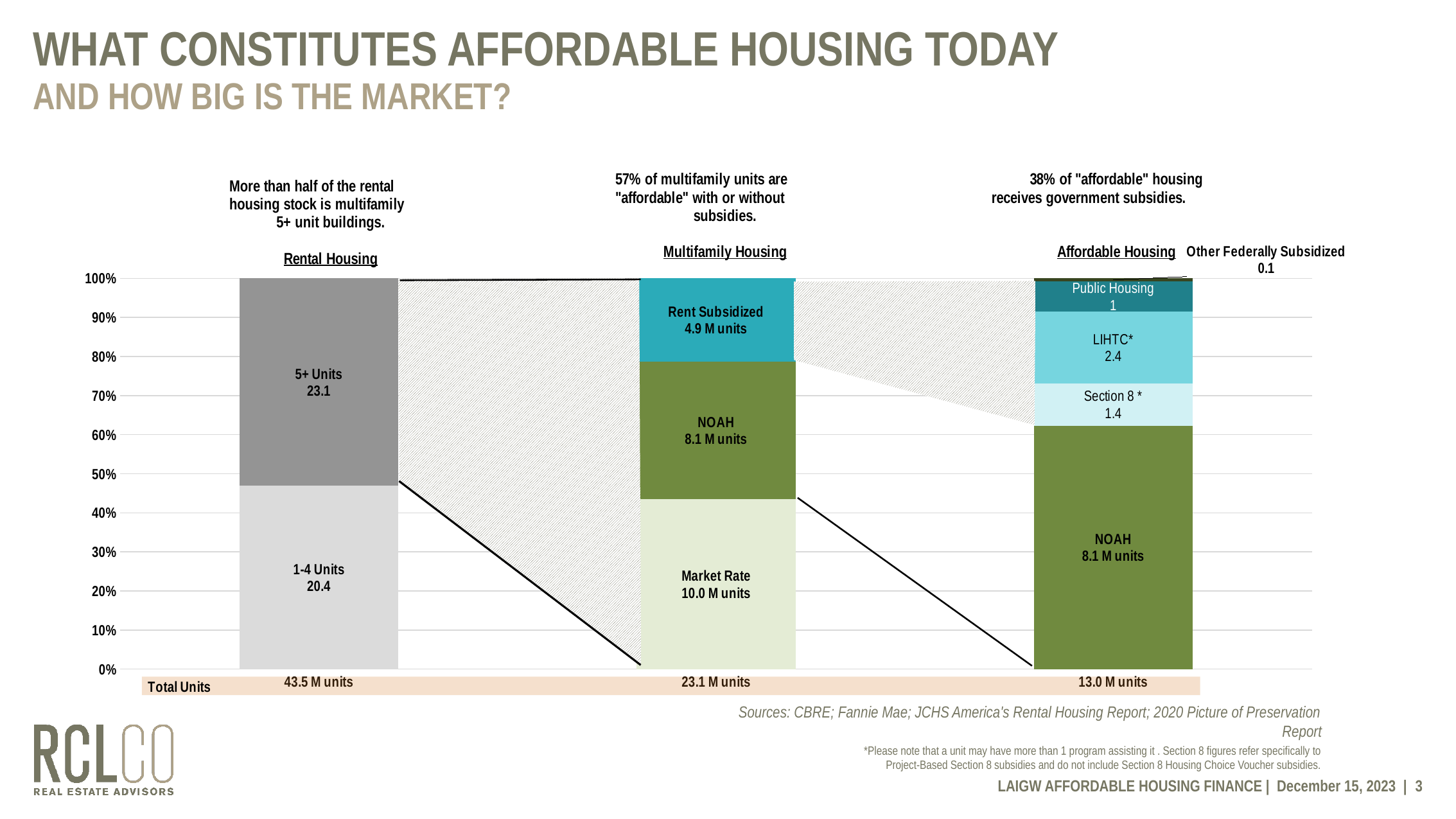
Which segment of the Affordable Housing bar has the smallest value? Other Federally Subsidized In the Rental Housing bar, how many units are in the 5+ Units segment? 23.1 According to the text above the chart, what percentage of "affordable" housing receives government subsidies? 38% How many stacked bars are shown in the chart? 3 In the Affordable Housing bar, what is the value shown for LIHTC*? 2.4 What is the Total Units figure shown for the Multifamily Housing bar? 23.1 M units In the Multifamily Housing bar, what is the value of the Market Rate segment? 10.0 M units Which segment of the Multifamily Housing bar has the largest number of units? Market Rate What kind of chart is shown on the slide? Stacked bar chart In the Affordable Housing bar, what is the value shown for Section 8 *? 1.4 In the Multifamily Housing bar, which is larger: Rent Subsidized or NOAH? NOAH In the Rental Housing bar, what is the difference between the 5+ Units value and the 1-4 Units value? 2.7